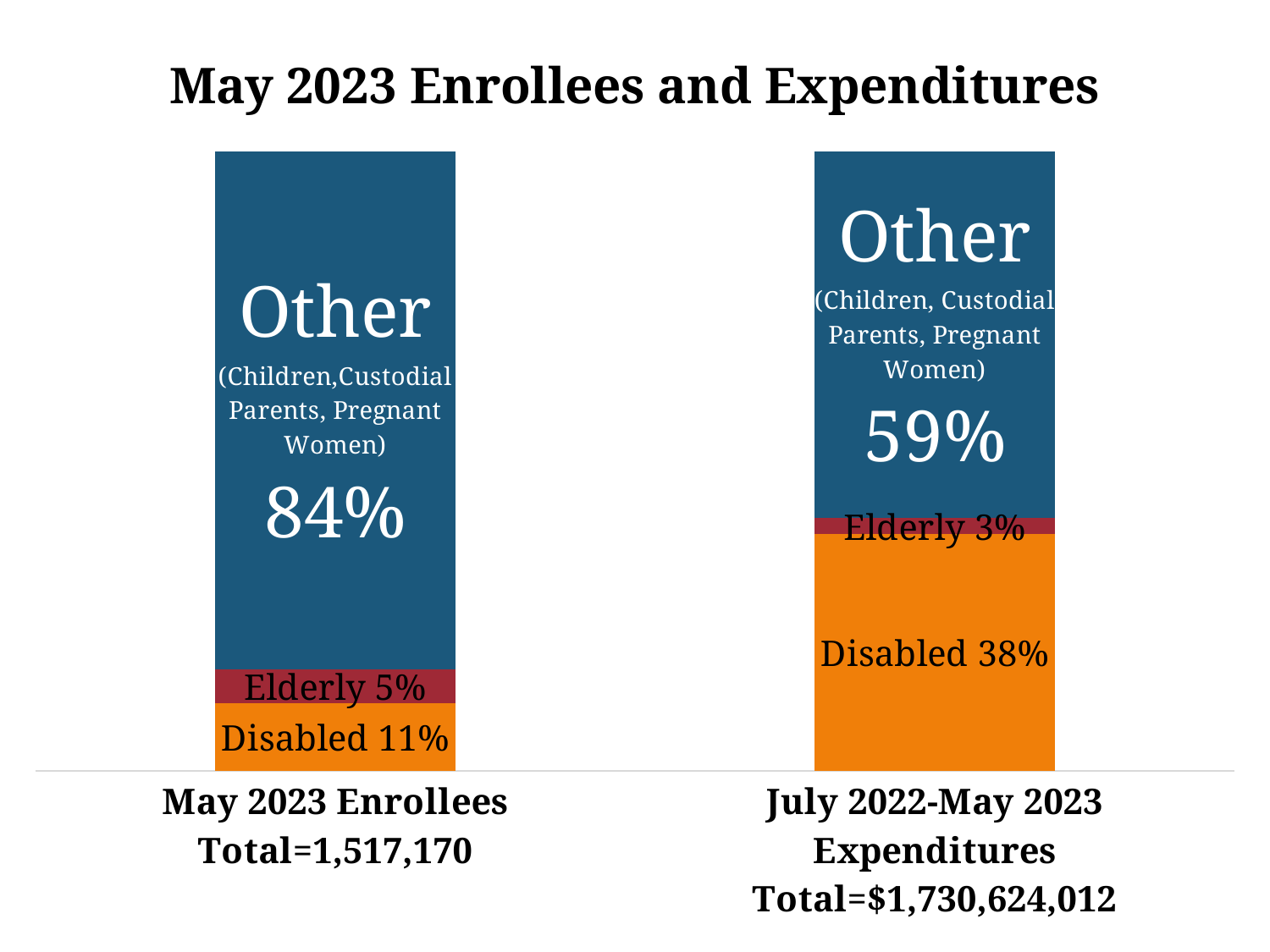
What is the total of July 2022-May 2023 Expenditures shown? $1,730,624,012 What is the total number of May 2023 Enrollees shown? 1,517,170 Which group has the largest share of May 2023 Enrollees? Other (Children, Custodial Parents, Pregnant Women) What share of July 2022-May 2023 Expenditures is Other (Children, Custodial Parents, Pregnant Women)? 59% Is the Disabled share larger for May 2023 Enrollees or for July 2022-May 2023 Expenditures? July 2022-May 2023 Expenditures What share of May 2023 Enrollees is Disabled? 11% What kind of chart is shown on the slide? Stacked bar chart What share of May 2023 Enrollees is Elderly? 5% What is the difference between the Disabled share of Expenditures and the Disabled share of Enrollees? 27 percentage points Which group has the smallest share of July 2022-May 2023 Expenditures? Elderly What share of July 2022-May 2023 Expenditures is Elderly? 3% How many stacked bars are shown on the slide? 2